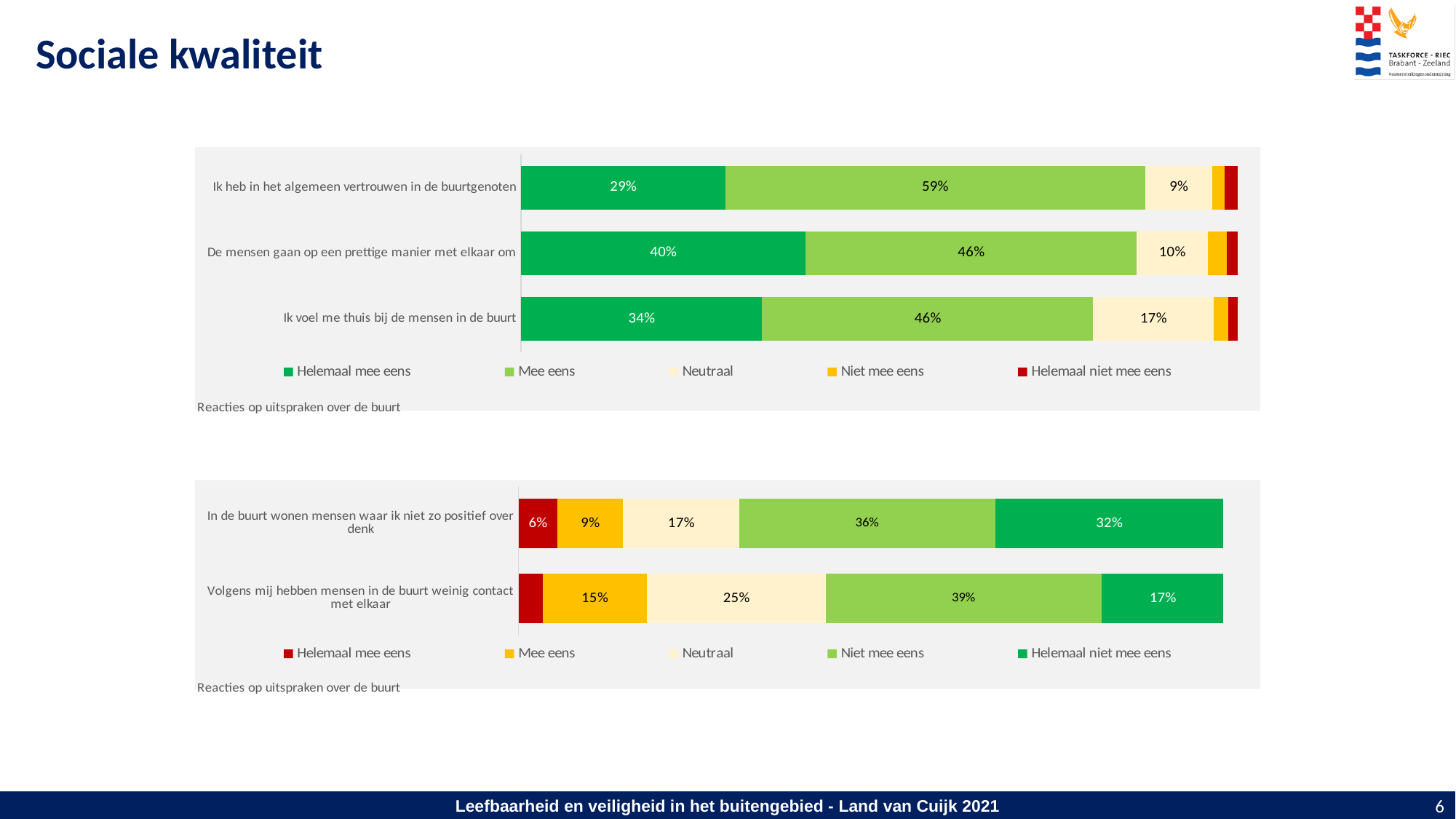
In the bottom chart, what is the 'Helemaal niet mee eens' value for 'In de buurt wonen mensen waar ik niet zo positief over denk'? 32% What type of chart is the top chart? Stacked bar chart In the bottom chart, which statement has the larger 'Mee eens' share? Volgens mij hebben mensen in de buurt weinig contact met elkaar In the bottom chart, what is the difference between the 'Niet mee eens' values of the two statements? 3% In the top chart, what is the difference between the 'Mee eens' values for 'Ik heb in het algemeen vertrouwen in de buurtgenoten' and 'Ik voel me thuis bij de mensen in de buurt'? 13% In the top chart, what is the 'Neutraal' value for 'Ik voel me thuis bij de mensen in de buurt'? 17% In the top chart, how many statements (categories) are shown? 3 In the top chart, what percentage of respondents answered 'Helemaal mee eens' to 'De mensen gaan op een prettige manier met elkaar om'? 40% How many series does the legend of the bottom chart list? 5 In the top chart, which statement has the highest 'Helemaal mee eens' share? De mensen gaan op een prettige manier met elkaar om In the bottom chart, what is the 'Neutraal' value for 'Volgens mij hebben mensen in de buurt weinig contact met elkaar'? 25% In the top chart, what is the 'Mee eens' value for 'Ik heb in het algemeen vertrouwen in de buurtgenoten'? 59%